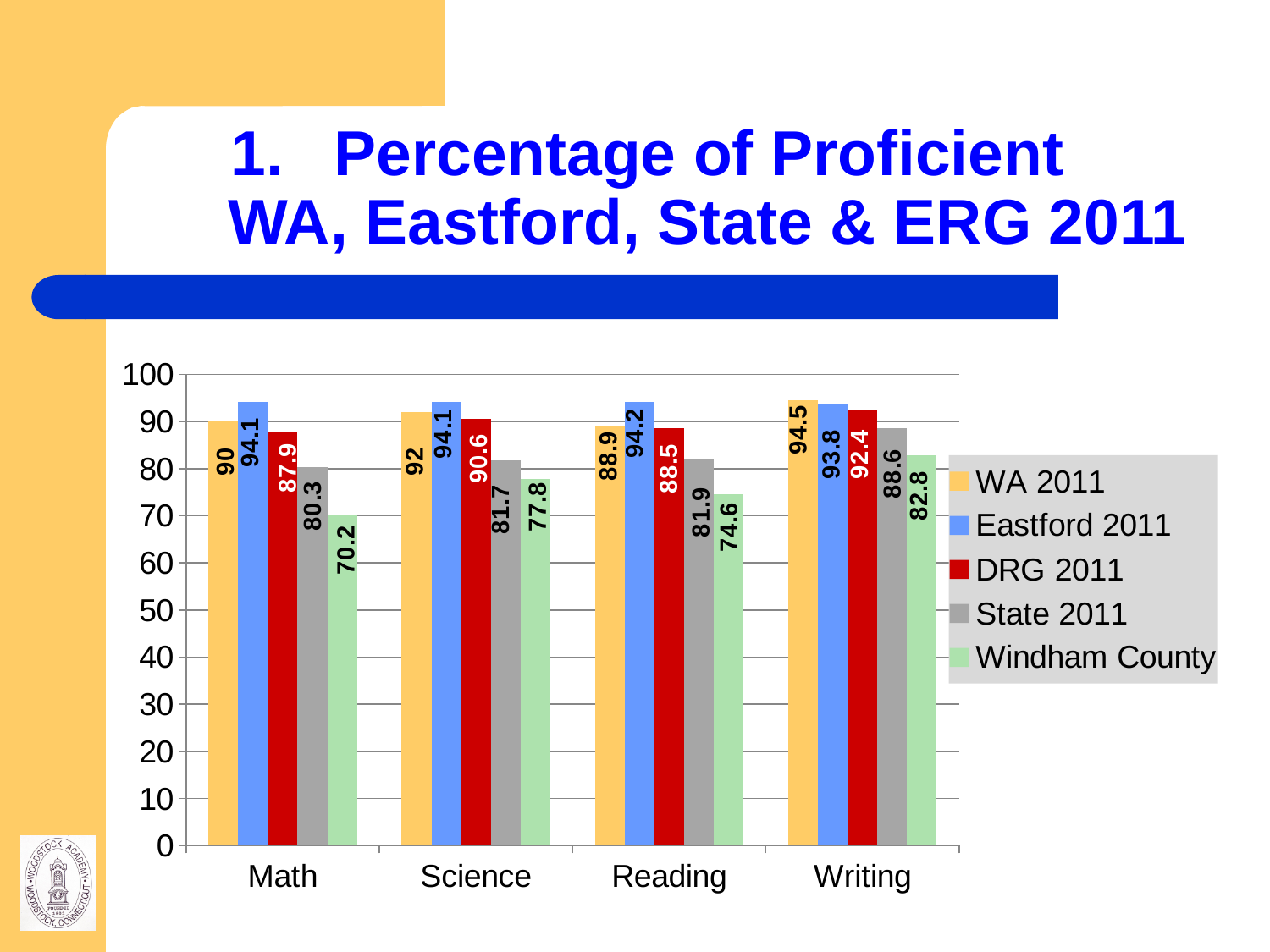
Which is larger, WA 2011 in Science or DRG 2011 in Science? WA 2011 in Science What is the value for Windham County in Reading? 74.6 What is the value for Eastford 2011 in Math? 94.1 Which series is shown in red in the legend? DRG 2011 What is the value for State 2011 in Writing? 88.6 What is the difference between Eastford 2011 and Windham County in Math? 23.9 Which series has the lowest value in Math? Windham County Which series has the highest value in Writing? WA 2011 How many subject categories are shown on the x axis? 4 What is the value for DRG 2011 in Science? 90.6 What kind of chart is shown on the slide? Bar chart How many series does the legend list? 5